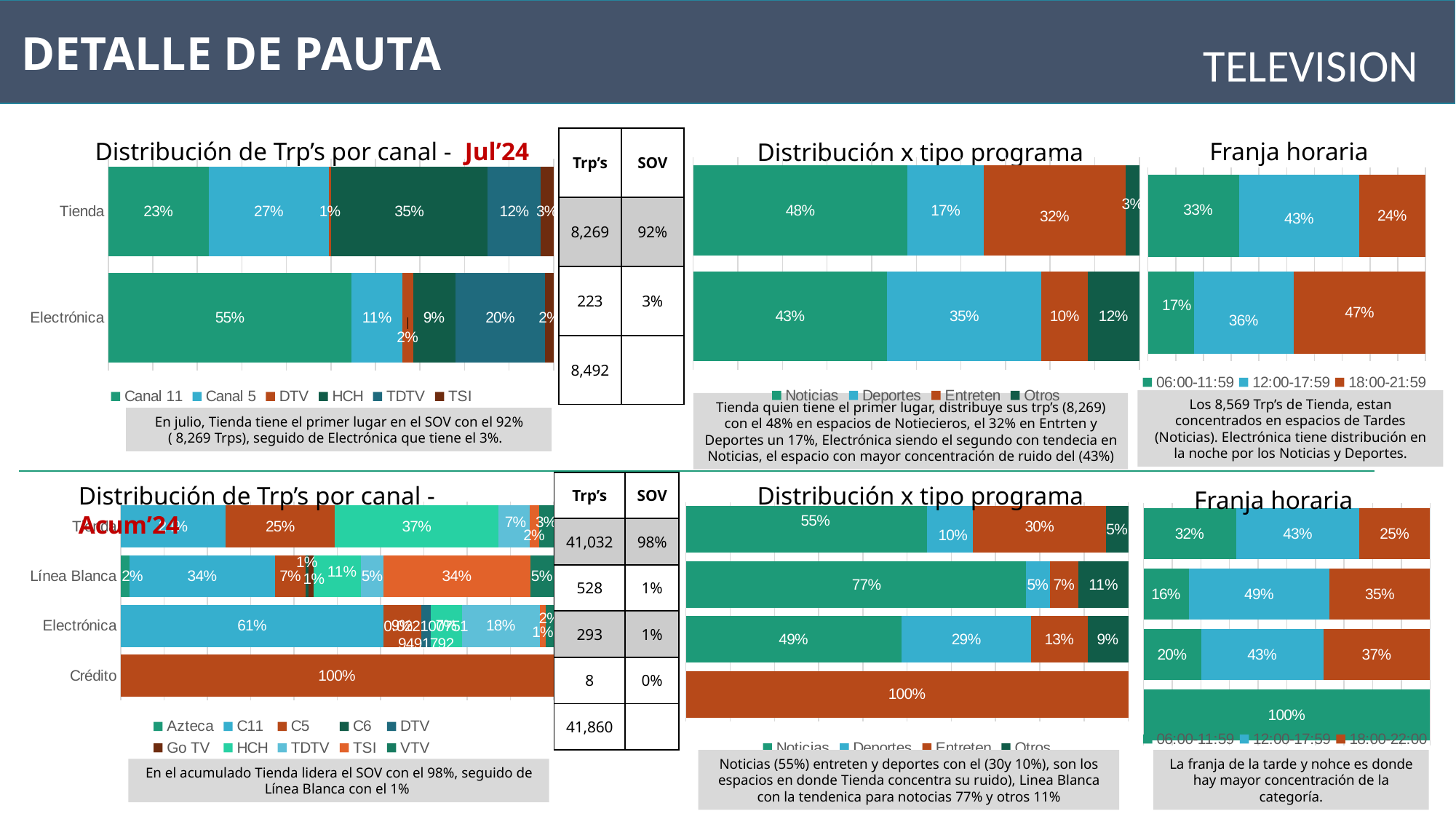
In the bottom 'Distribución x tipo programa' chart, what is the Noticias share for the second bar (Línea Blanca)? 77% In the top 'Distribución x tipo programa' chart, what is the difference between the Deportes shares of Electrónica and Tienda? 18% In the top 'Franja horaria' chart, what is the 18:00-21:59 share for Electrónica? 47% In the top 'Franja horaria' chart, which time slot has the largest share for Tienda? 12:00-17:59 What kind of chart is the top-left 'Distribución de Trp's por canal - Jul'24'? Stacked bar chart In the top-left chart 'Distribución de Trp's por canal - Jul'24', what is the Canal 11 share for Electrónica? 55% How many series does the legend of the bottom-left chart 'Distribución de Trp's por canal - Acum'24' list? 10 In the top 'Distribución x tipo programa' chart, what is the Noticias share for Tienda? 48% In the top 'Distribución x tipo programa' chart, which segment is largest for Electrónica? Noticias How many series does the legend of the top-left chart 'Distribución de Trp's por canal - Jul'24' list? 6 In the top-left chart 'Distribución de Trp's por canal - Jul'24', what is the HCH share for Tienda? 35% How many categories are shown in the bottom-left chart 'Distribución de Trp's por canal - Acum'24'? 4